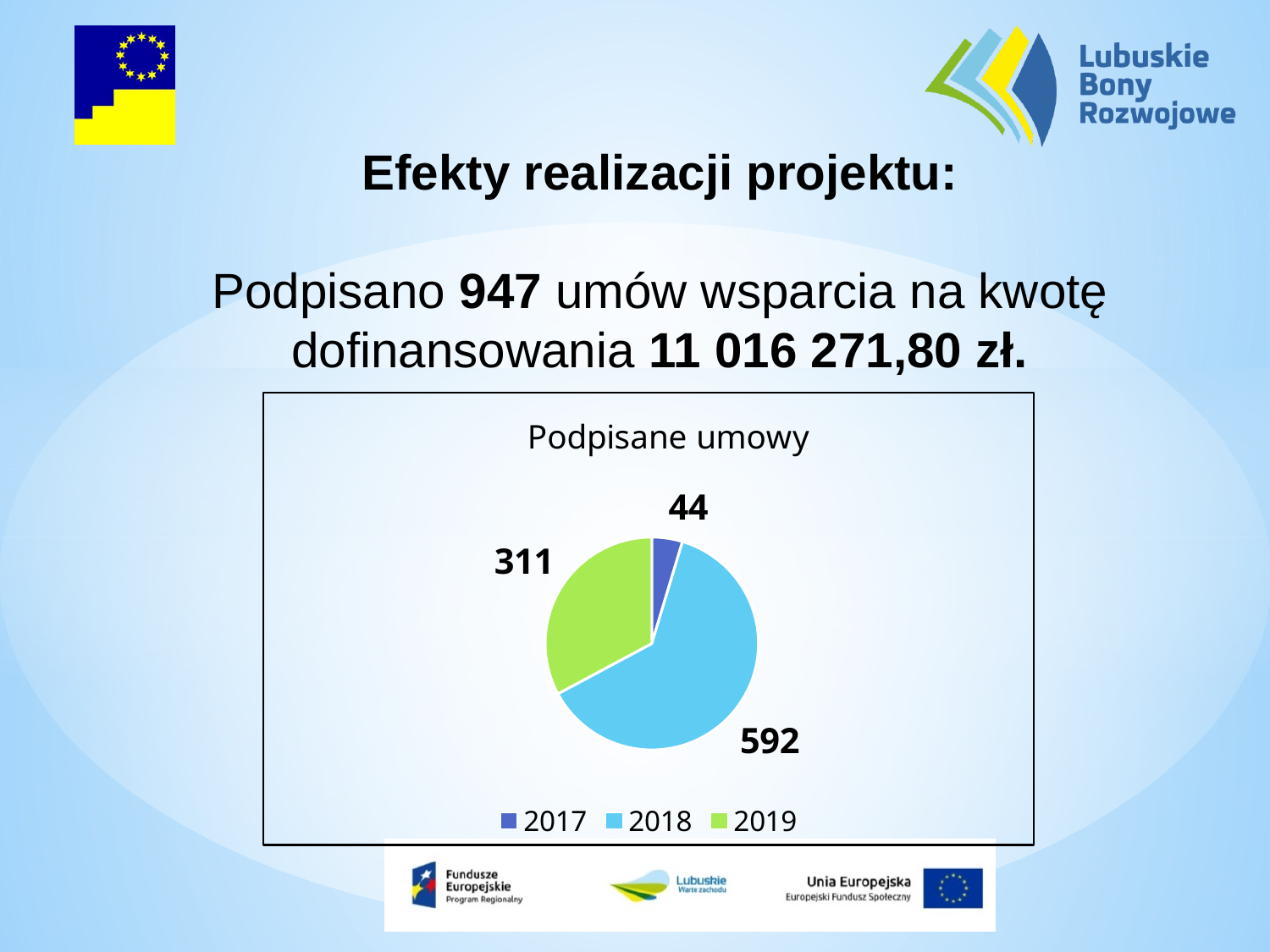
Which year has the largest slice of the pie? 2018 How many slices does the pie chart have? 3 What kind of chart is shown on the slide? pie chart Which year has the smallest slice of the pie? 2017 How many signed agreements does the chart show for 2019? 311 What is the difference between the values for 2018 and 2019? 281 Which is larger, the value for 2019 or the value for 2017? 2019 What is the title of the chart? Podpisane umowy How many entries does the legend list? 3 How many signed agreements does the chart show for 2017? 44 How many signed agreements does the chart show for 2018? 592 What is the total of all three slices in the pie chart? 947